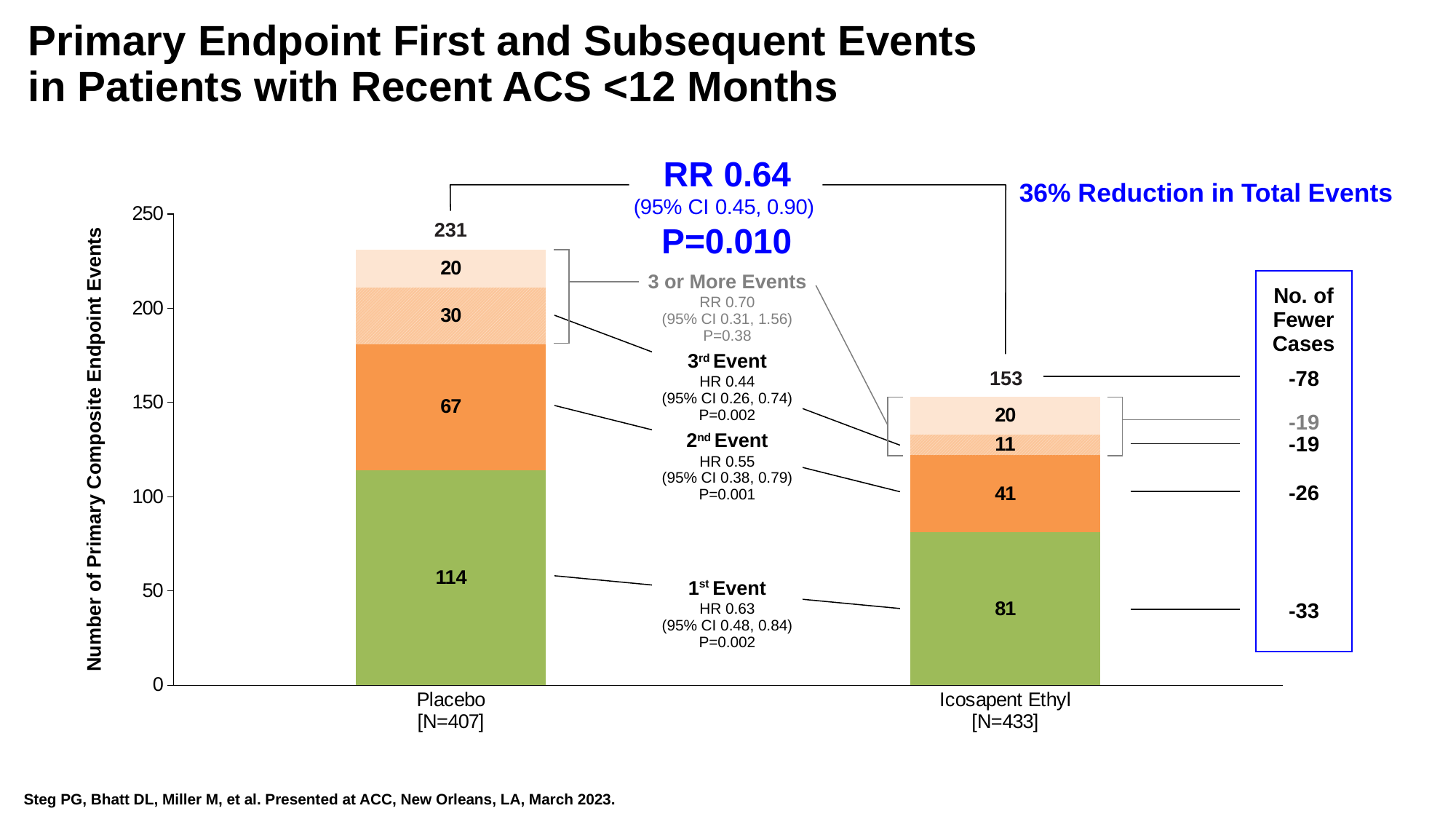
How many treatment groups are shown on the x axis? 2 What is the number of 3rd events in the Placebo group? 30 Which group has the higher total number of events, Placebo or Icosapent Ethyl? Placebo What is the number of 2nd events in the Icosapent Ethyl group? 41 What is the y-axis label of the chart? Number of Primary Composite Endpoint Events What kind of chart is shown on the slide? Stacked bar chart What is the difference in total events between the Placebo and Icosapent Ethyl groups? 78 What is the number of 1st events in the Icosapent Ethyl group? 81 What is the difference in 2nd events between the Placebo and Icosapent Ethyl groups? 26 What is the total number of primary composite endpoint events for the Icosapent Ethyl bar? 153 What is the total number of primary composite endpoint events for the Placebo bar? 231 What is the number of 1st events in the Placebo group? 114